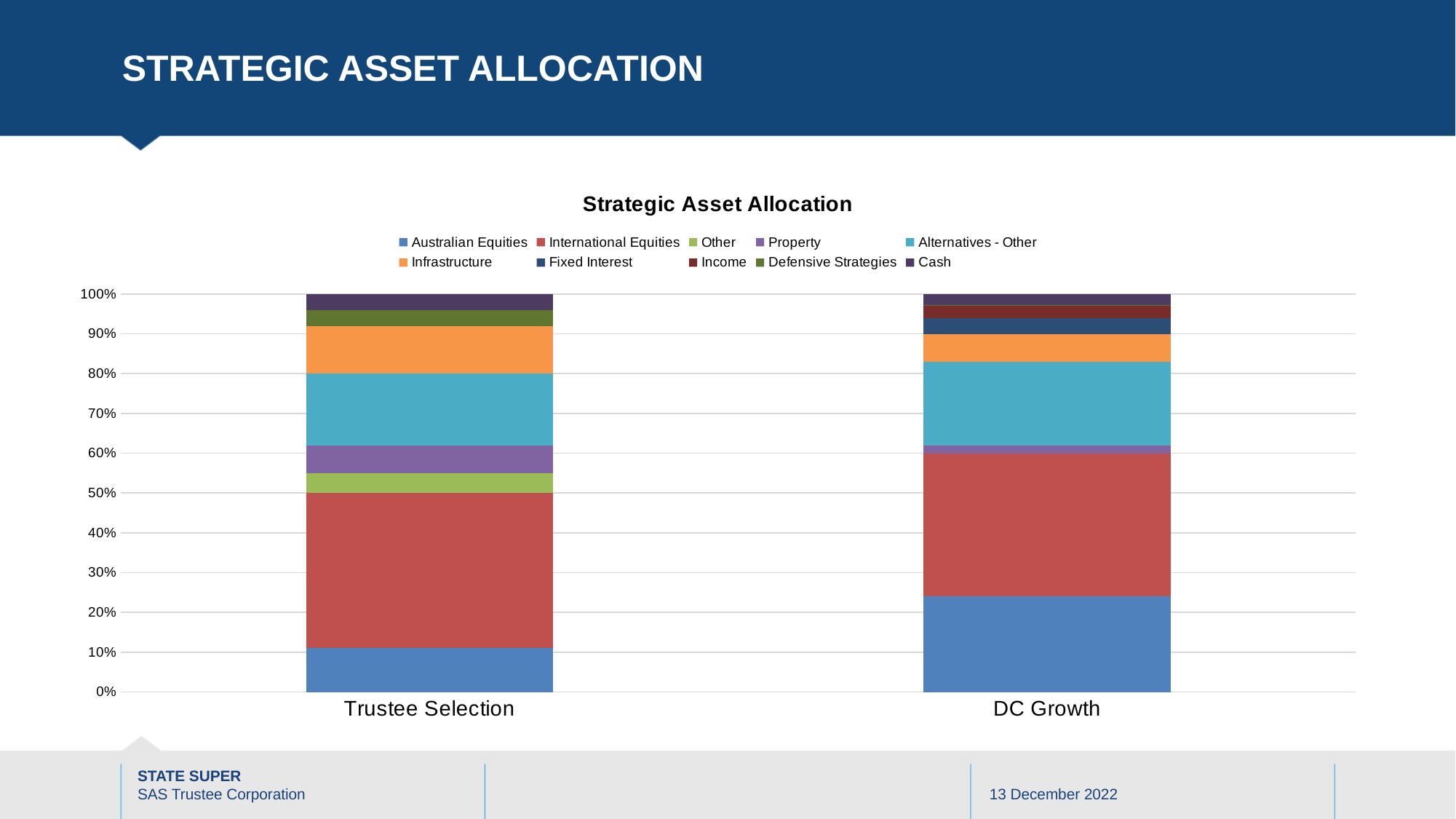
Is the Australian Equities value for Trustee Selection greater or less than 20%? less Is the Australian Equities value for DC Growth greater or less than 20%? greater How many categories are shown on the x axis of the chart? 2 What is the total of the stacked bar for Trustee Selection? 100% What kind of chart is shown on the slide? Stacked bar chart How many series does the chart's legend list? 10 Which category has the larger Property allocation, Trustee Selection or DC Growth? Trustee Selection Which category has the larger Australian Equities allocation, Trustee Selection or DC Growth? DC Growth Which series is the largest segment in the Trustee Selection bar? International Equities What is the title of the chart? Strategic Asset Allocation Which series is shown in the legend immediately after Infrastructure? Fixed Interest Which category has the larger Infrastructure allocation, Trustee Selection or DC Growth? Trustee Selection